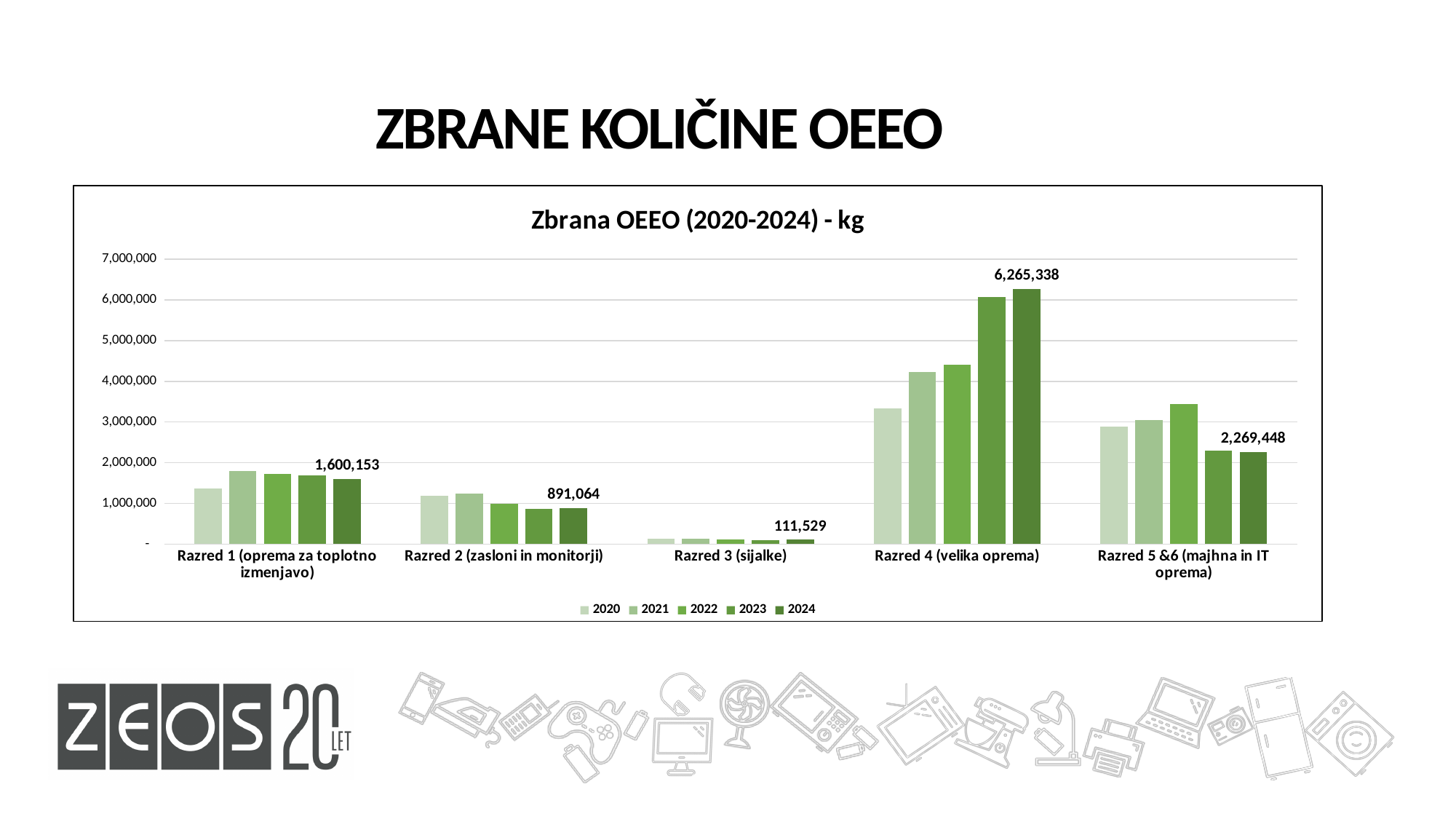
Is the 2020 value for Razred 4 (velika oprema) greater or less than 3,000,000? greater What is the 2024 value for Razred 3 (sijalke)? 111,529 What is the difference between the 2024 values for Razred 4 (velika oprema) and Razred 5 &6 (majhna in IT oprema)? 3,995,890 Which category has the highest 2024 value? Razred 4 (velika oprema) Do the values for Razred 4 (velika oprema) rise or fall from 2020 to 2024? rise How many categories are shown on the x axis? 5 Which category has the lowest 2024 value? Razred 3 (sijalke) What is the 2024 value for Razred 4 (velika oprema)? 6,265,338 What is the 2024 value for Razred 1 (oprema za toplotno izmenjavo)? 1,600,153 What is the 2024 value for Razred 5 &6 (majhna in IT oprema)? 2,269,448 How many series does the legend list? 5 Which has the larger 2024 value, Razred 1 (oprema za toplotno izmenjavo) or Razred 2 (zasloni in monitorji)? Razred 1 (oprema za toplotno izmenjavo)